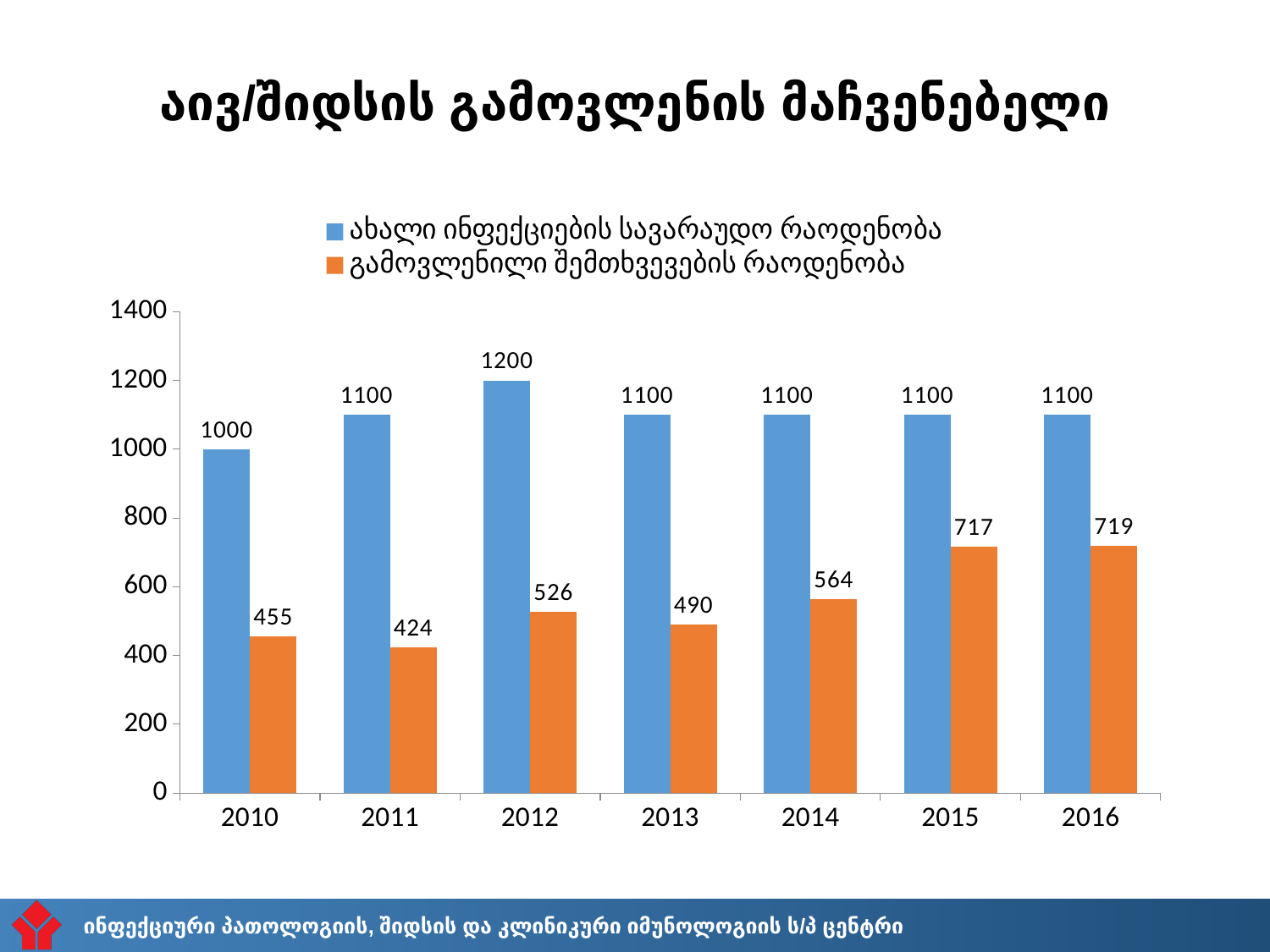
What kind of chart is shown on the slide? bar chart In which year is the blue series (ახალი ინფექციების სავარაუდო რაოდენობა) highest? 2012 How many series does the legend list? 2 How many years are shown on the x axis? 7 What is the difference between the blue and orange values in 2016? 381 In which year is the orange series (გამოვლენილი შემთხვევების რაოდენობა) lowest? 2011 What is the value of the blue series (ახალი ინფექციების სავარაუდო რაოდენობა) for 2012? 1200 Is the orange value for 2015 greater or less than 600? greater Which is larger: the orange value for 2013 or the orange value for 2012? 2012 What is the value of the orange series (გამოვლენილი შემთხვევების რაოდენობა) for 2014? 564 What is the value of the orange series (გამოვლენილი შემთხვევების რაოდენობა) for 2010? 455 Which colour represents გამოვლენილი შემთხვევების რაოდენობა in the legend? orange